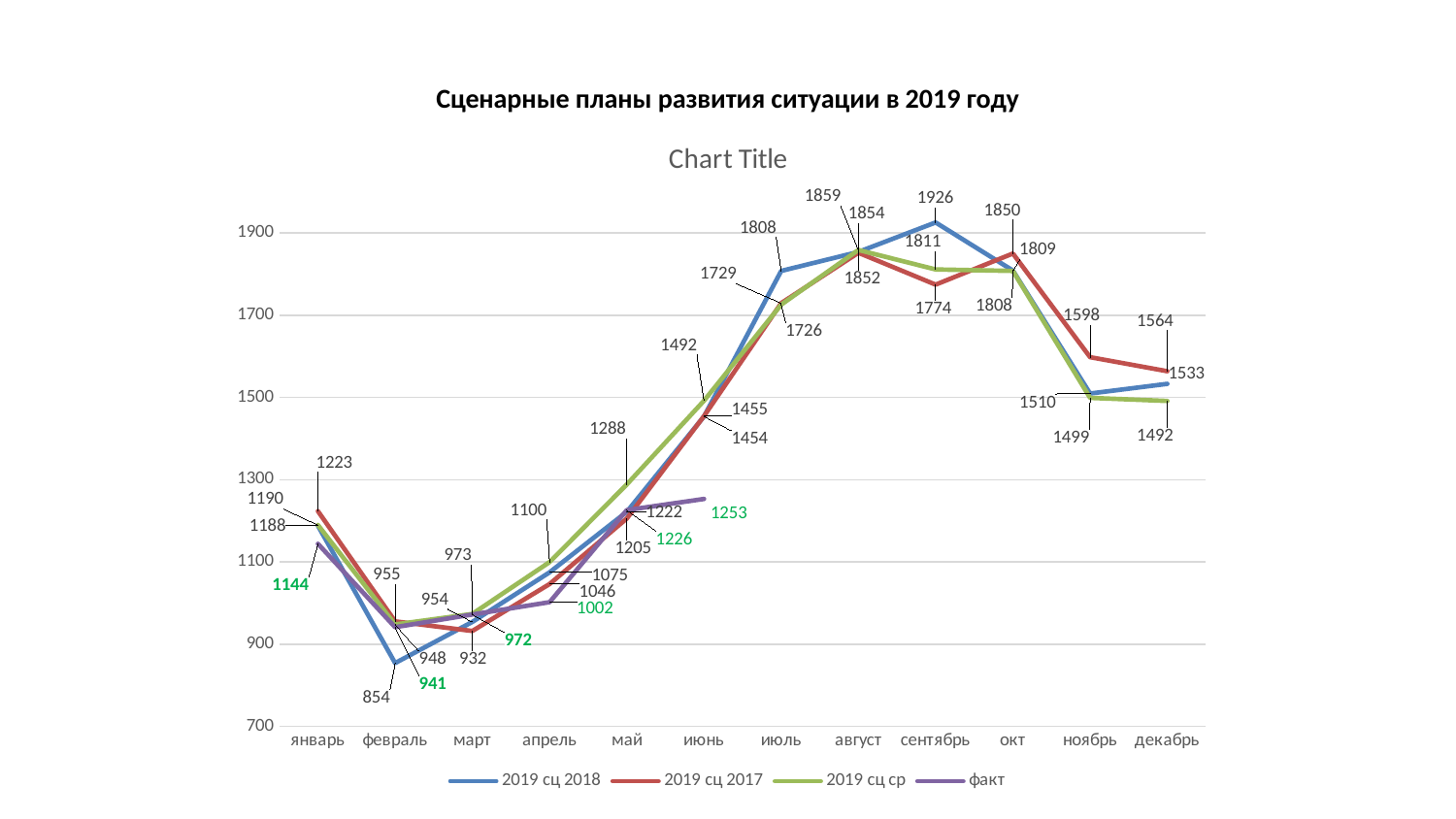
Is the value of the факт series in апрель greater or less than 1100? less How many series does the chart legend list? 4 How many months are shown on the x axis of the chart? 12 What kind of chart is shown on the slide? line chart In which month does the 2019 сц 2018 series reach its highest value? сентябрь What is the value of the факт series in июнь? 1253 What is the difference between the факт values in июнь and май? 27 What is the value of the 2019 сц 2017 series in декабрь? 1564 What is the value of the факт series in январь? 1144 What is the lowest value plotted on the chart, and in which month does it occur? 854, февраль Does the факт series rise or fall from февраль to июнь? rise In декабрь, which is larger: 2019 сц 2017 or 2019 сц ср? 2019 сц 2017